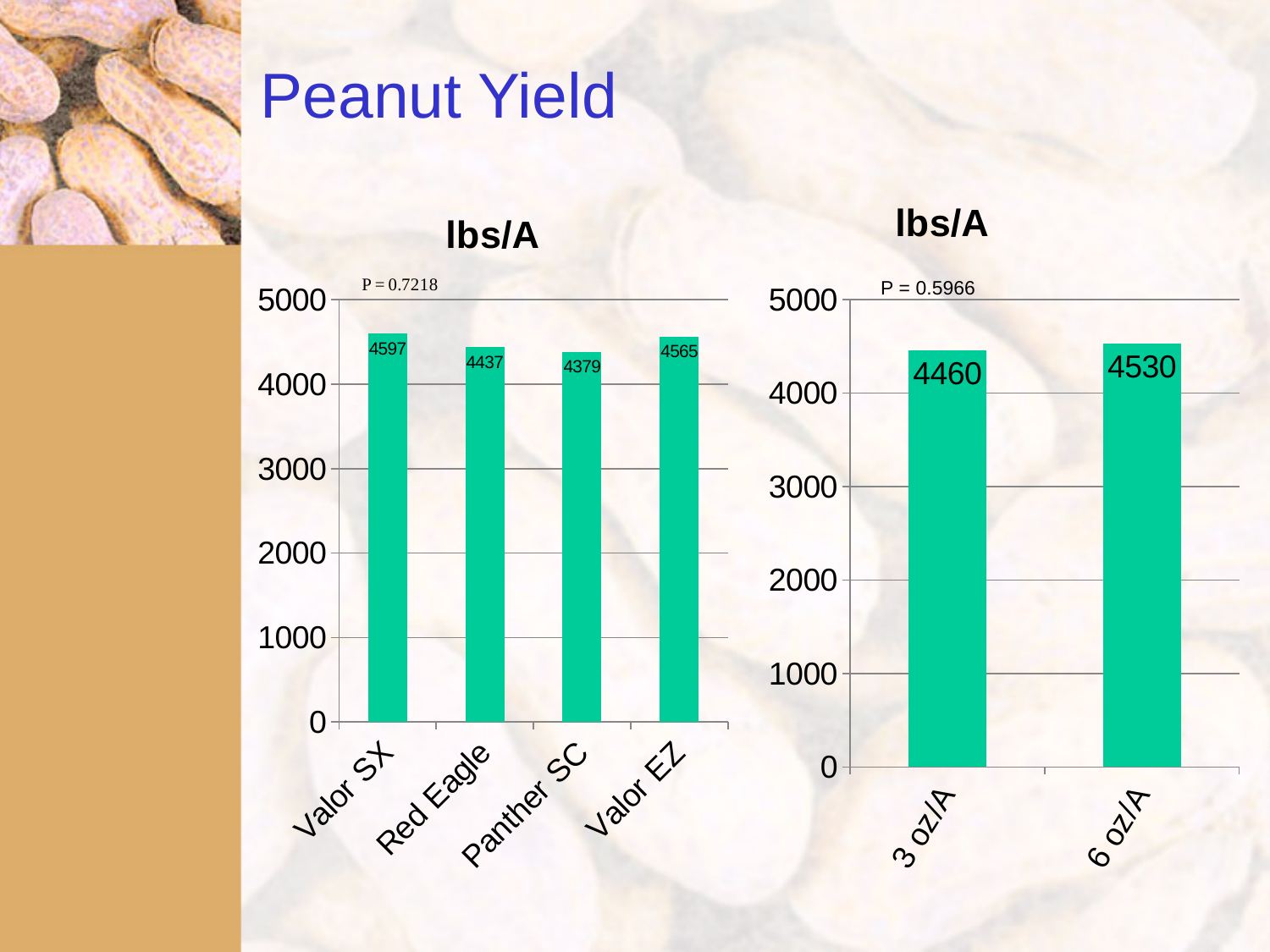
How many products are shown in the left chart? 4 In the right chart, which rate has the higher yield, 3 oz/A or 6 oz/A? 6 oz/A In the right chart, what is the difference in yield between 6 oz/A and 3 oz/A? 70 How many bars are shown in the right chart? 2 In the left chart, what is the yield for Panther SC? 4379 In the left chart, what is the difference in yield between Valor SX and Panther SC? 218 In the left chart, which product has the lowest yield? Panther SC What P value is shown on the right chart? P = 0.5966 What type of chart is the left chart? bar chart In the left chart, which product has the highest yield? Valor SX In the left chart, what is the yield for Valor SX? 4597 In the right chart, what is the yield for 6 oz/A? 4530